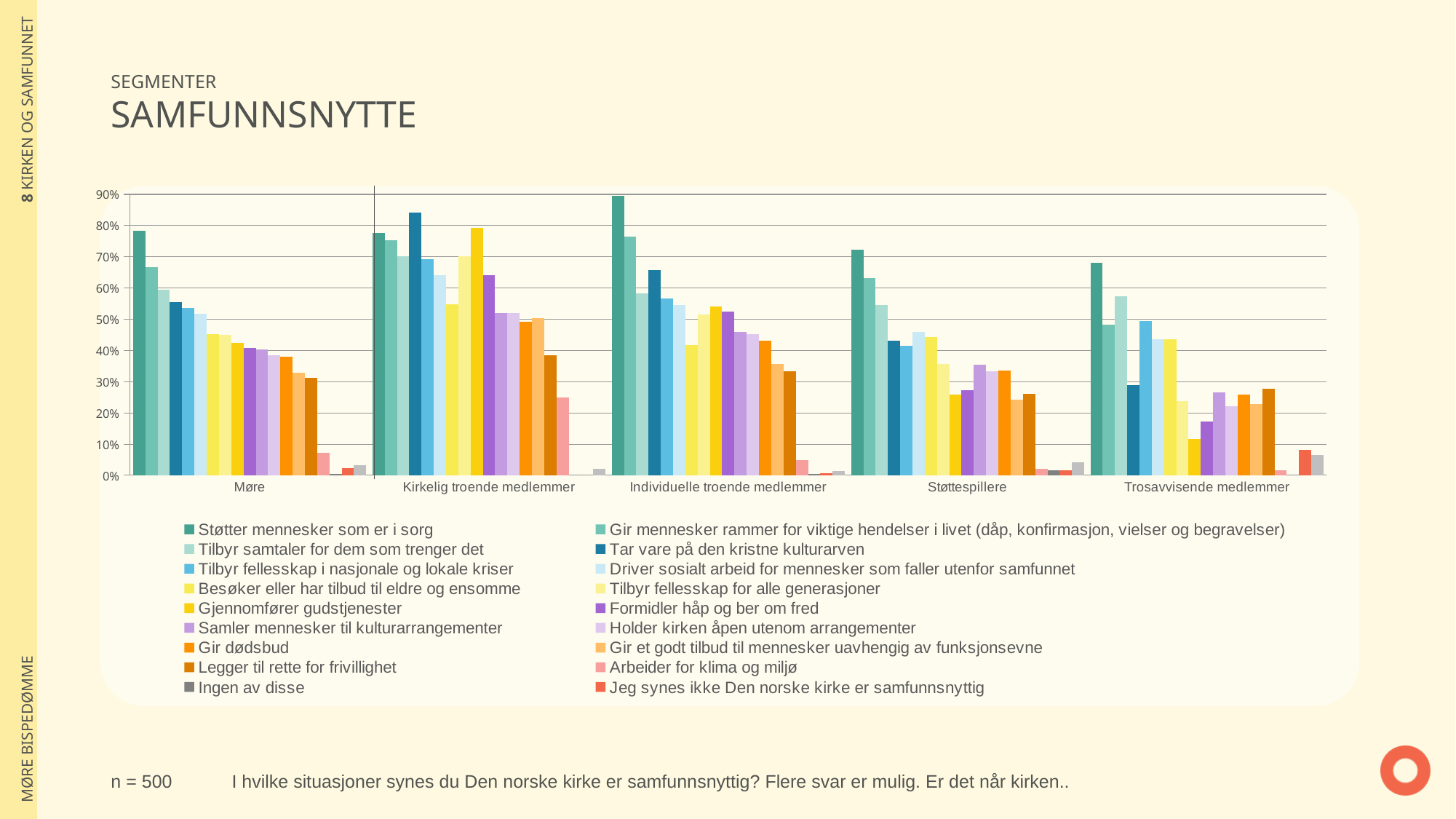
Which series has the highest value in the Individuelle troende medlemmer category? Støtter mennesker som er i sorg How many categories (segments) are shown along the x axis? 5 Is the value for 'Tar vare på den kristne kulturarven' among Kirkelig troende medlemmer greater or less than 80%? greater Is the value for 'Arbeider for klima og miljø' in the Møre category greater or less than 10%? less Is the value for 'Arbeider for klima og miljø' among Kirkelig troende medlemmer greater or less than 20%? greater What kind of chart is shown on the slide? bar chart How many series does the legend list? 18 Which series has the highest value in the Kirkelig troende medlemmer category? Tar vare på den kristne kulturarven What is the highest value shown on the y axis of the chart? 90% For 'Gjennomfører gudstjenester', which category has the larger value: Kirkelig troende medlemmer or Individuelle troende medlemmer? Kirkelig troende medlemmer For 'Støtter mennesker som er i sorg', which category has the larger value: Individuelle troende medlemmer or Støttespillere? Individuelle troende medlemmer